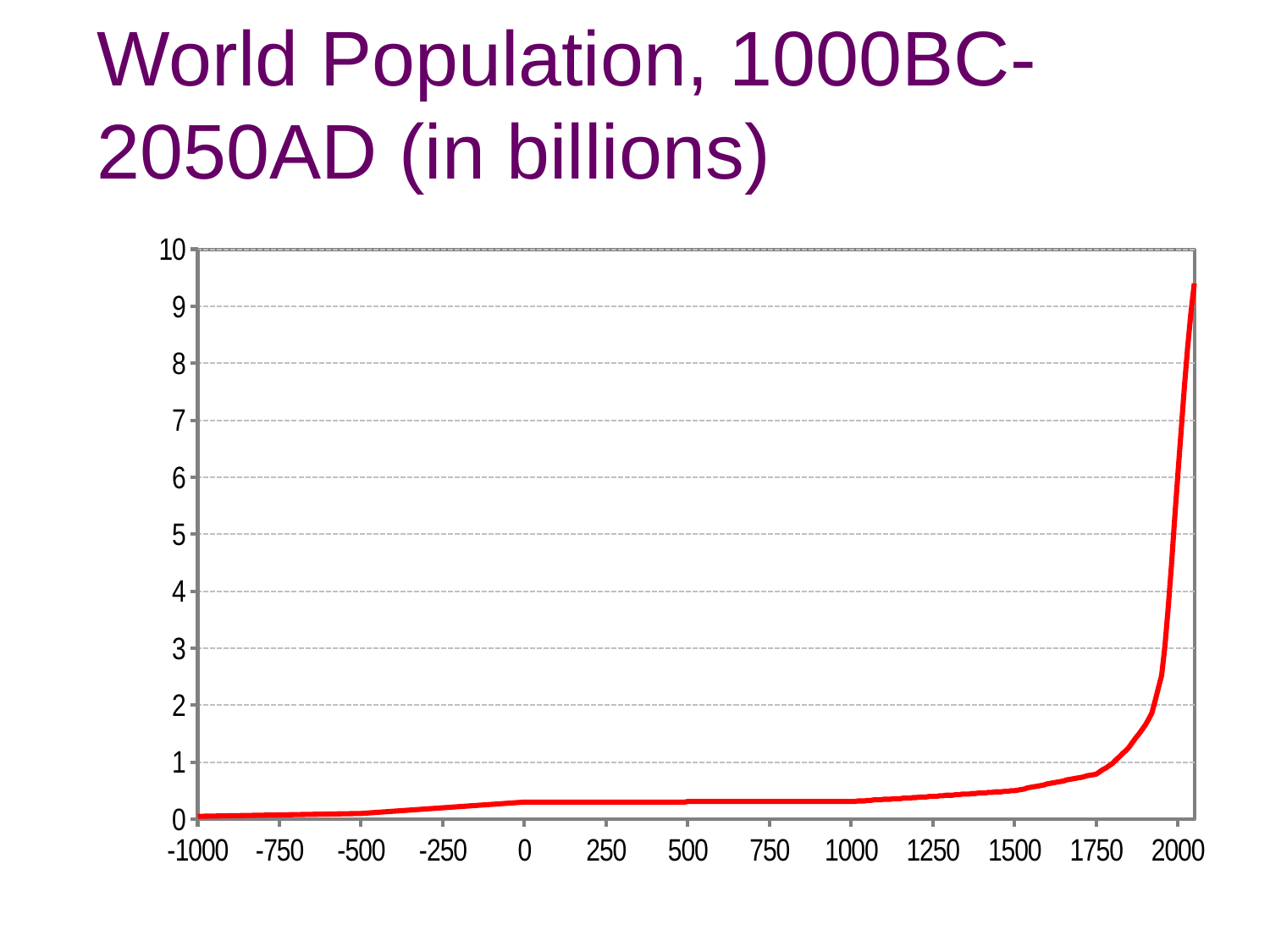
Is the value for the year 0 greater or less than 1? less Is the value for the year 2000 greater or less than 5? greater Is the value for the year 1000 greater or less than 1? less Is the line at its highest at the left end or the right end of the x axis? right end What is the title of the chart? World Population, 1000BC-2050AD (in billions) Does the world population rise or fall as the years increase along the x axis? rise What kind of chart is shown on the slide? line chart What colour is the plotted line? red How many labelled tick marks are on the x axis? 13